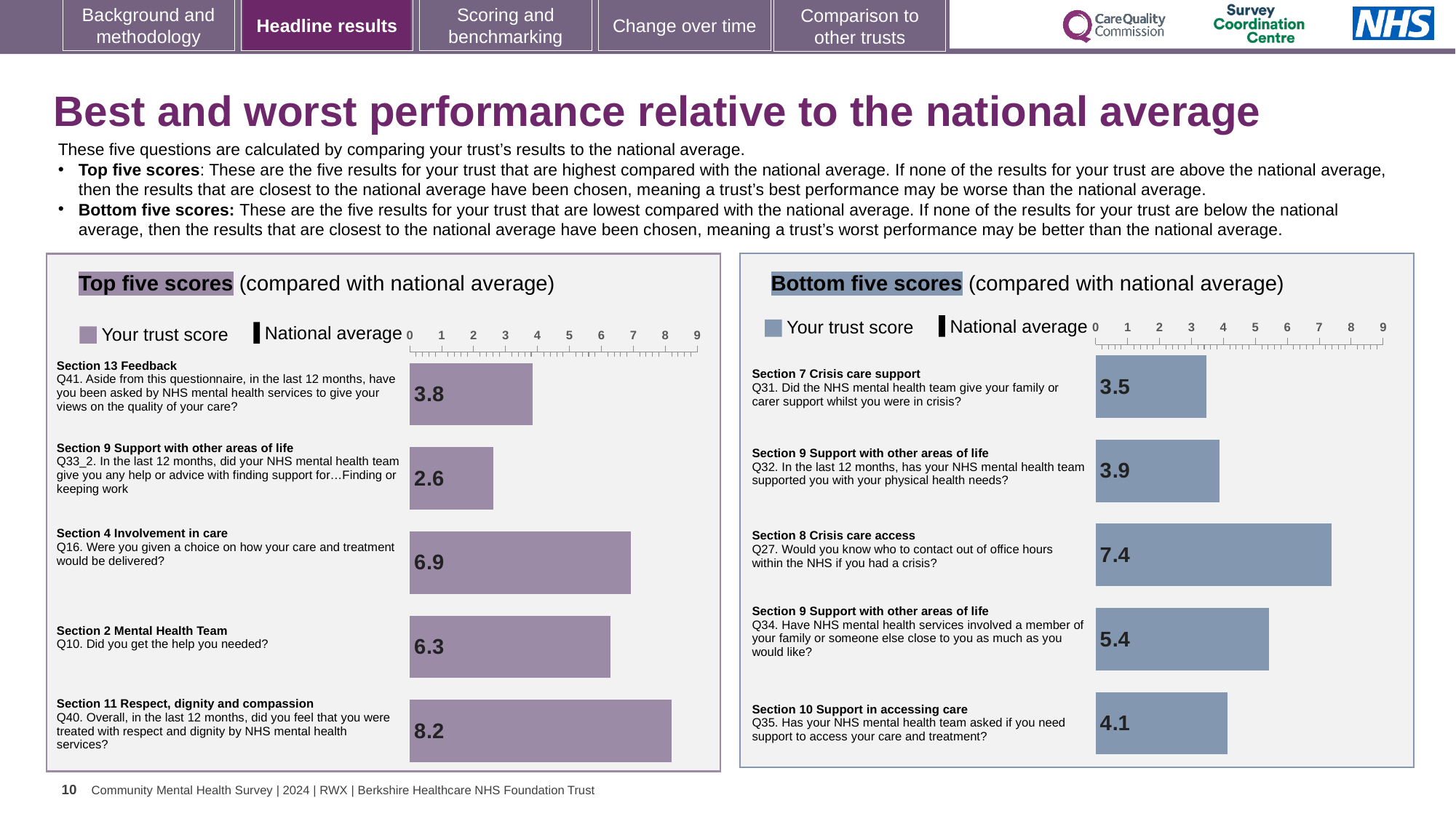
In the Top five scores chart, what is the trust score for Q33_2 (help finding or keeping work)? 2.6 How many questions are plotted in the Bottom five scores chart? 5 In the Bottom five scores chart, which question has the lowest trust score? Q31 In the Bottom five scores chart, what is the trust score for Q27 (know who to contact out of office hours)? 7.4 In the Bottom five scores chart, what is the difference between the trust scores for Q34 and Q35? 1.3 What type of chart is the Top five scores chart? Bar chart In the Top five scores chart, what is the difference between the trust scores for Q16 and Q10? 0.6 In the Top five scores chart, what is the trust score for Q40 (treated with respect and dignity)? 8.2 In the Bottom five scores chart, what is the trust score for Q31 (family or carer support whilst in crisis)? 3.5 In the Bottom five scores chart, which has the larger trust score, Q32 or Q35? Q35 In the Top five scores chart, which question has the highest trust score? Q40 How many entries does the legend of the Top five scores chart list? 2